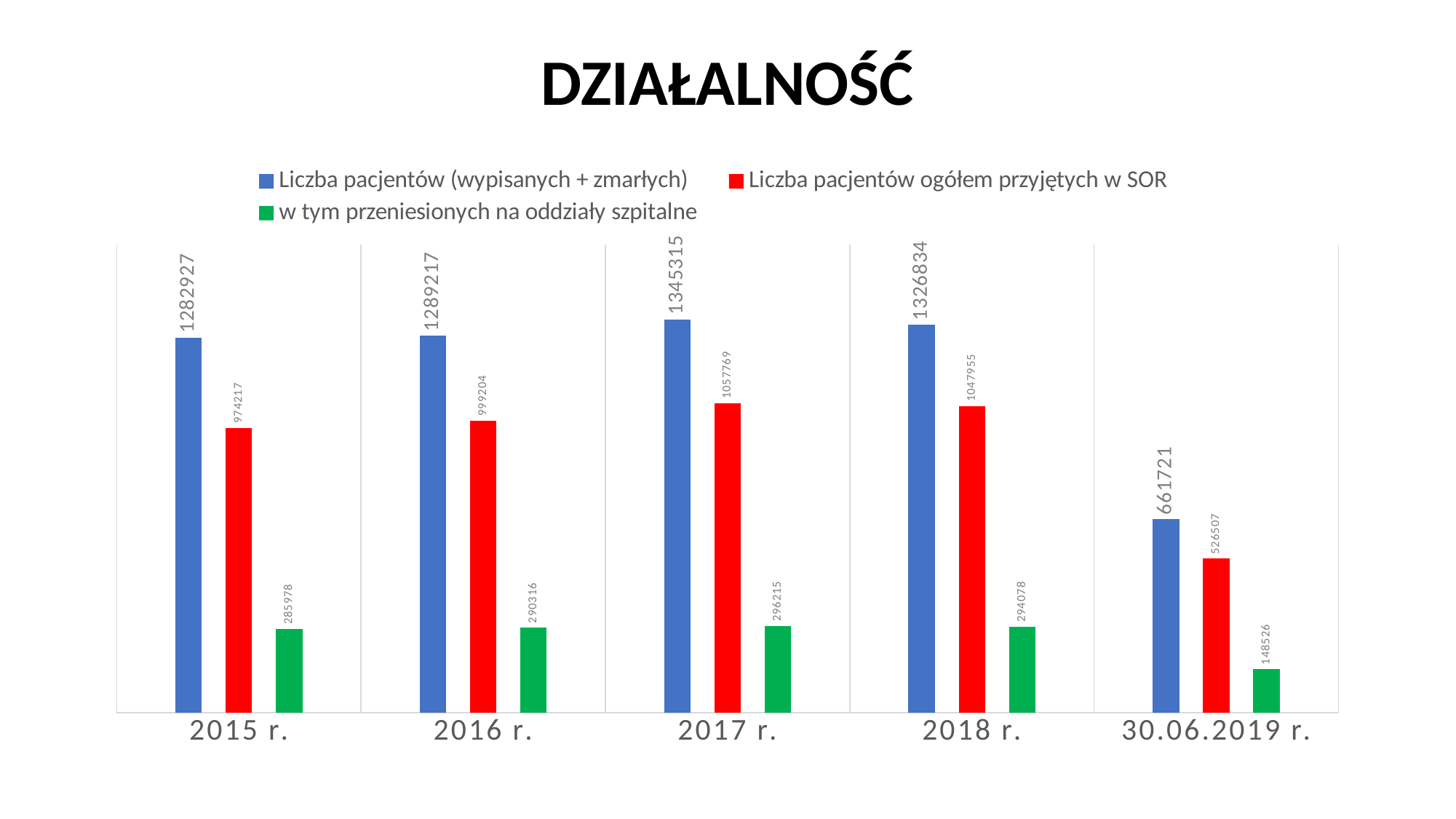
How many categories are shown on the x axis? 5 How many series does the legend list? 3 What is the difference between 'Liczba pacjentów ogółem przyjętych w SOR' in 2018 r. and 2015 r.? 73738 In which year is 'Liczba pacjentów (wypisanych + zmarłych)' the highest? 2017 r. What kind of chart is shown on the slide? Bar chart What is the value of 'Liczba pacjentów ogółem przyjętych w SOR' for 2017 r.? 1057769 What is the value of 'Liczba pacjentów (wypisanych + zmarłych)' for 2015 r.? 1282927 In which period is 'w tym przeniesionych na oddziały szpitalne' the lowest? 30.06.2019 r. What is the difference between 'Liczba pacjentów (wypisanych + zmarłych)' in 2017 r. and 2016 r.? 56098 What is the value of 'Liczba pacjentów ogółem przyjętych w SOR' for 2016 r.? 999204 Which is larger: 'Liczba pacjentów ogółem przyjętych w SOR' in 2017 r. or in 2018 r.? 2017 r. What is the value of 'w tym przeniesionych na oddziały szpitalne' for 30.06.2019 r.? 148526